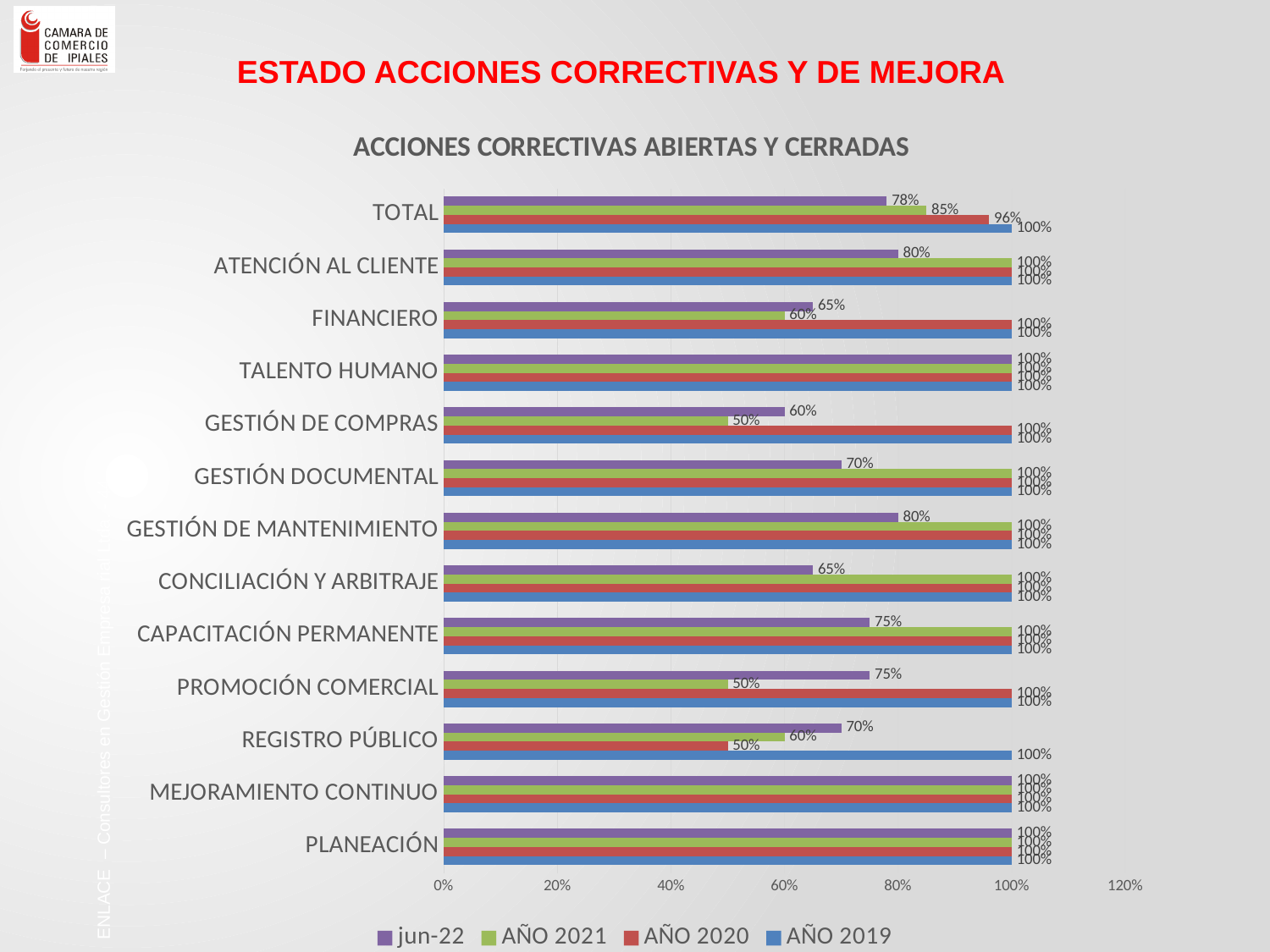
What is the jun-22 value for CONCILIACIÓN Y ARBITRAJE? 65% What is the AÑO 2021 value for GESTIÓN DE COMPRAS? 50% What is the AÑO 2020 value for REGISTRO PÚBLICO? 50% What is the title of the chart? ACCIONES CORRECTIVAS ABIERTAS Y CERRADAS How many series does the legend list? 4 What is the difference between the AÑO 2019 and jun-22 values for TOTAL? 22% What kind of chart is shown on the slide? Bar chart What is the difference between the jun-22 and AÑO 2021 values for PROMOCIÓN COMERCIAL? 25% Which series has the lowest value for TOTAL? jun-22 How many categories are shown on the vertical axis of the chart? 13 Which is larger for FINANCIERO: the jun-22 value or the AÑO 2021 value? jun-22 What is the jun-22 value for TOTAL? 78%